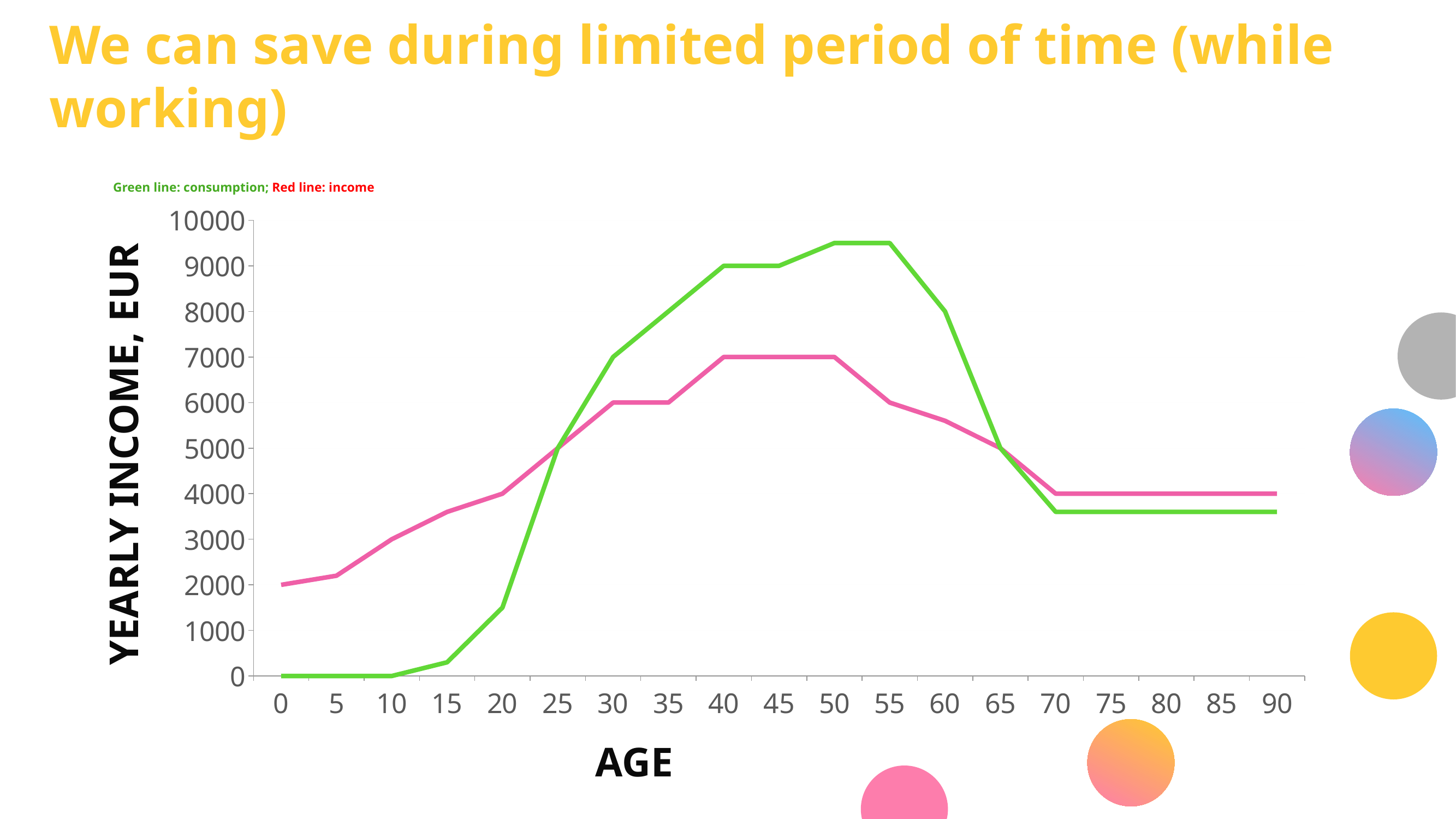
What kind of chart is shown on the slide? line chart Is the consumption (green line) at age 50 greater or less than 9000? greater What is the income (red line) at age 40? 7000 What is the consumption (green line) at age 60? 8000 What is the income (red line) at age 0? 2000 What is the title of the vertical axis? YEARLY INCOME, EUR What is the difference between consumption and income at age 40? 2000 What is the consumption (green line) at age 30? 7000 How many lines (series) does the chart show? 2 Is the consumption (green line) at age 80 greater or less than 4000? less At age 45, which is higher, consumption or income? consumption At age 10, which is higher, consumption or income? income